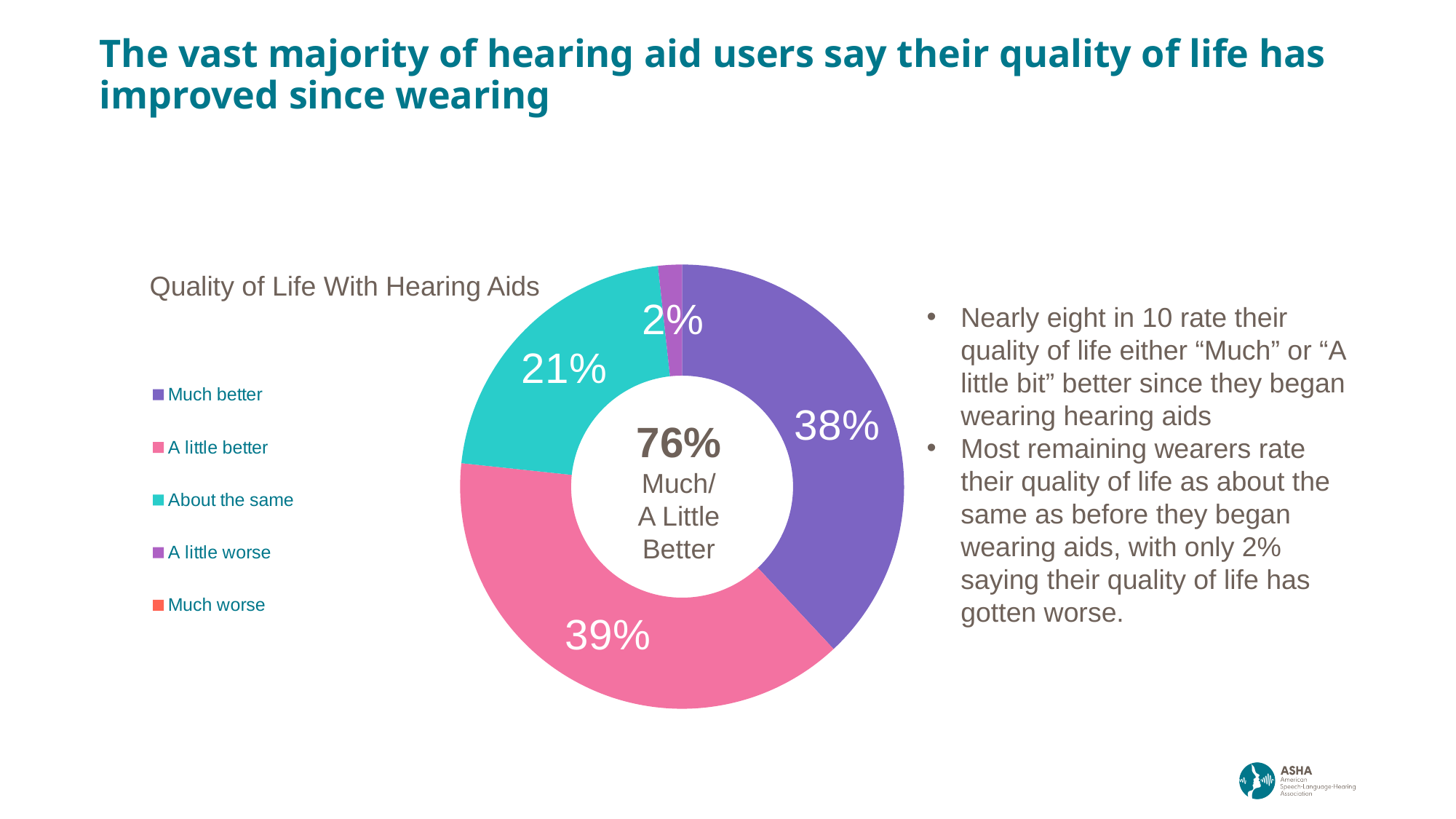
Among the slices with a printed percentage, which category has the smallest share? A little worse What percentage of hearing aid users say their quality of life is "Much better"? 38% What is the title of the chart? Quality of Life With Hearing Aids How many categories does the legend list? 5 What type of chart is shown on the slide? Pie chart (donut) What percentage of hearing aid users say their quality of life is "About the same"? 21% What percentage is shown in the center of the donut chart? 76% What percentage of hearing aid users say their quality of life is "A little better"? 39% What percentage of hearing aid users say their quality of life is "A little worse"? 2% What is the difference in percentage points between "About the same" and "A little worse"? 19 Which is larger, the share for "Much better" or the share for "About the same"? Much better Which category has the largest share of the chart? A little better